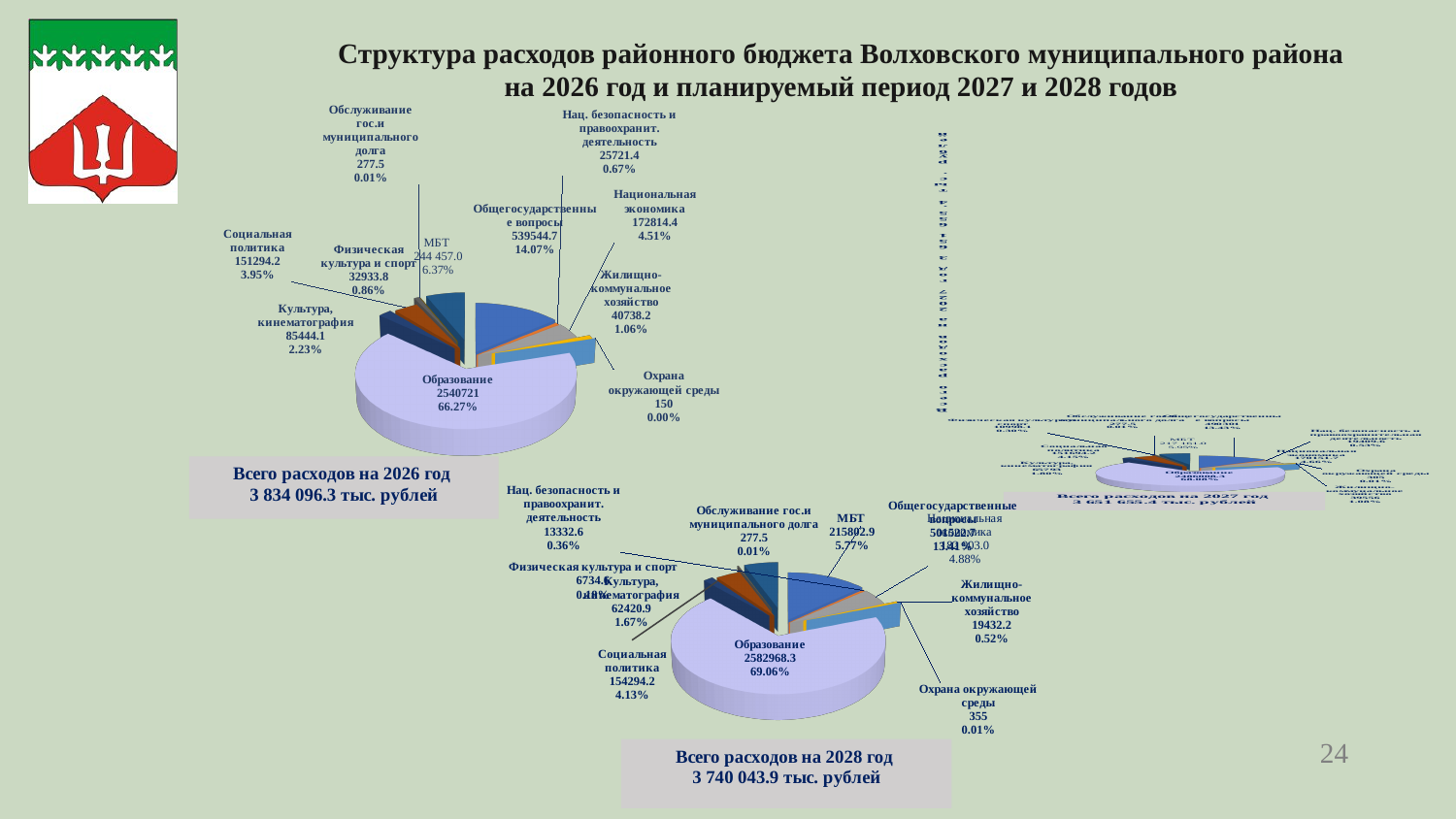
On the 2026 pie chart, what share of expenditures does Образование account for? 66.27% On the 2026 pie chart, which category has the smallest value? Охрана окружающей среды What total expenditure is stated for 2028 on the slide? 3 740 043.9 тыс. рублей On the 2028 pie chart (Всего расходов на 2028 год), what is the value shown for Образование? 2582968.3 On the 2026 pie chart, what percentage is shown for Национальная экономика? 4.51% On the 2028 pie chart, what percentage is shown for Социальная политика? 4.13% On the 2026 pie chart (Всего расходов на 2026 год), what is the value shown for Образование? 2540721 On the 2026 pie chart, which is larger: Социальная политика or Культура, кинематография? Социальная политика On the 2026 pie chart, what is the value shown for Общегосударственные вопросы? 539544.7 On the 2026 pie chart, which category has the largest share? Образование What type of chart is used to show the budget expenditure structure on this slide? Pie chart On the 2026 pie chart, what is the difference between the values for Социальная политика (151294.2) and Культура, кинематография (85444.1)? 65850.1